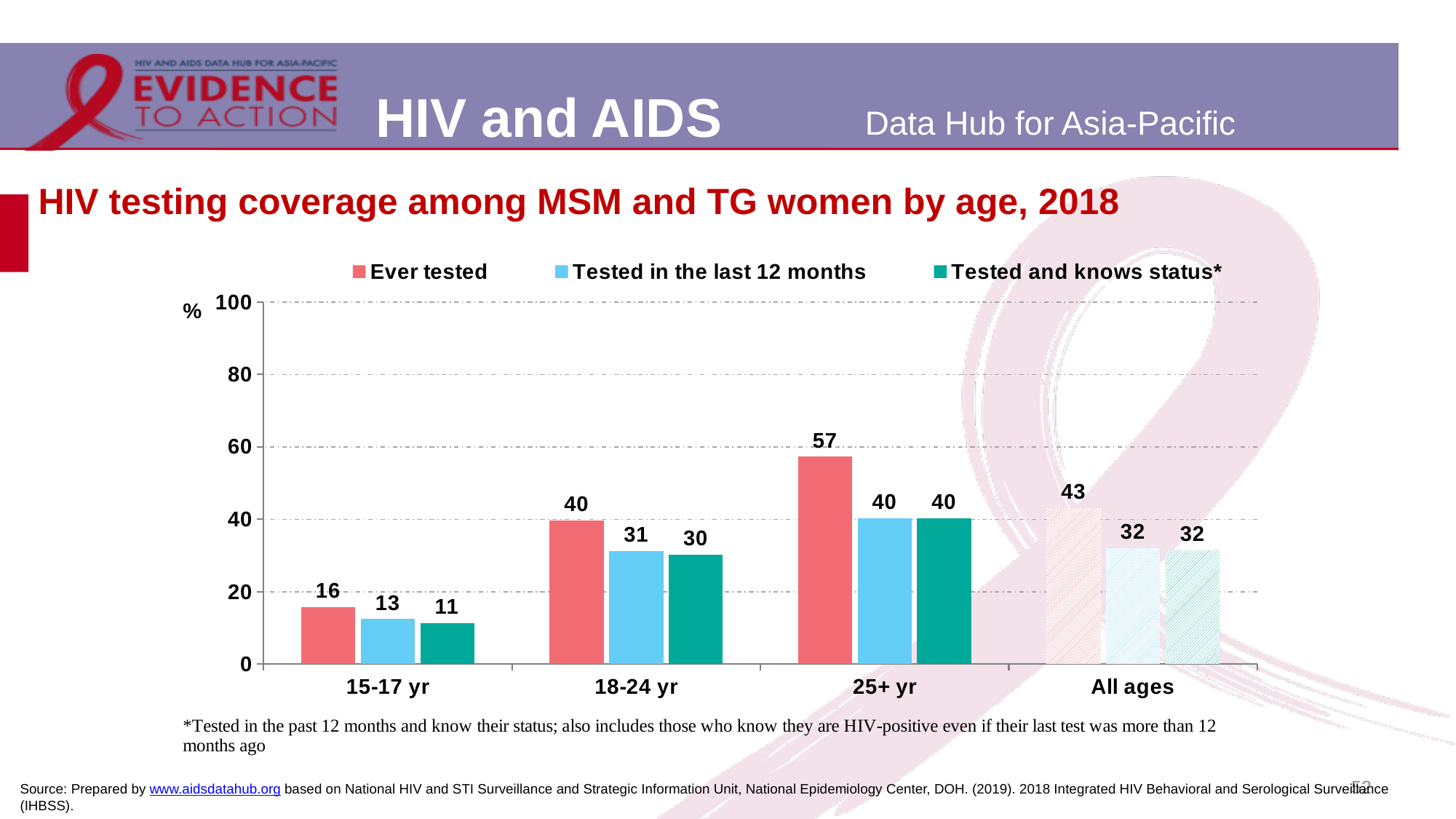
How many series does the legend list? 3 What kind of chart is shown on the slide? Bar chart What is the difference between the 'Ever tested' values for the 25+ yr and 15-17 yr age groups? 41 What is the title of the chart? HIV testing coverage among MSM and TG women by age, 2018 Which is larger: 'Ever tested' for 18-24 yr or 'Ever tested' for All ages? All ages Which age group has the highest 'Ever tested' value? 25+ yr What is the value for 'Tested and knows status*' in the 15-17 yr age group? 11 What is the value for 'Ever tested' in the 25+ yr age group? 57 Which age group has the lowest 'Tested in the last 12 months' value? 15-17 yr What is the value for 'Ever tested' for All ages? 43 What is the value for 'Tested in the last 12 months' in the 18-24 yr age group? 31 How many age groups are shown on the x axis? 4